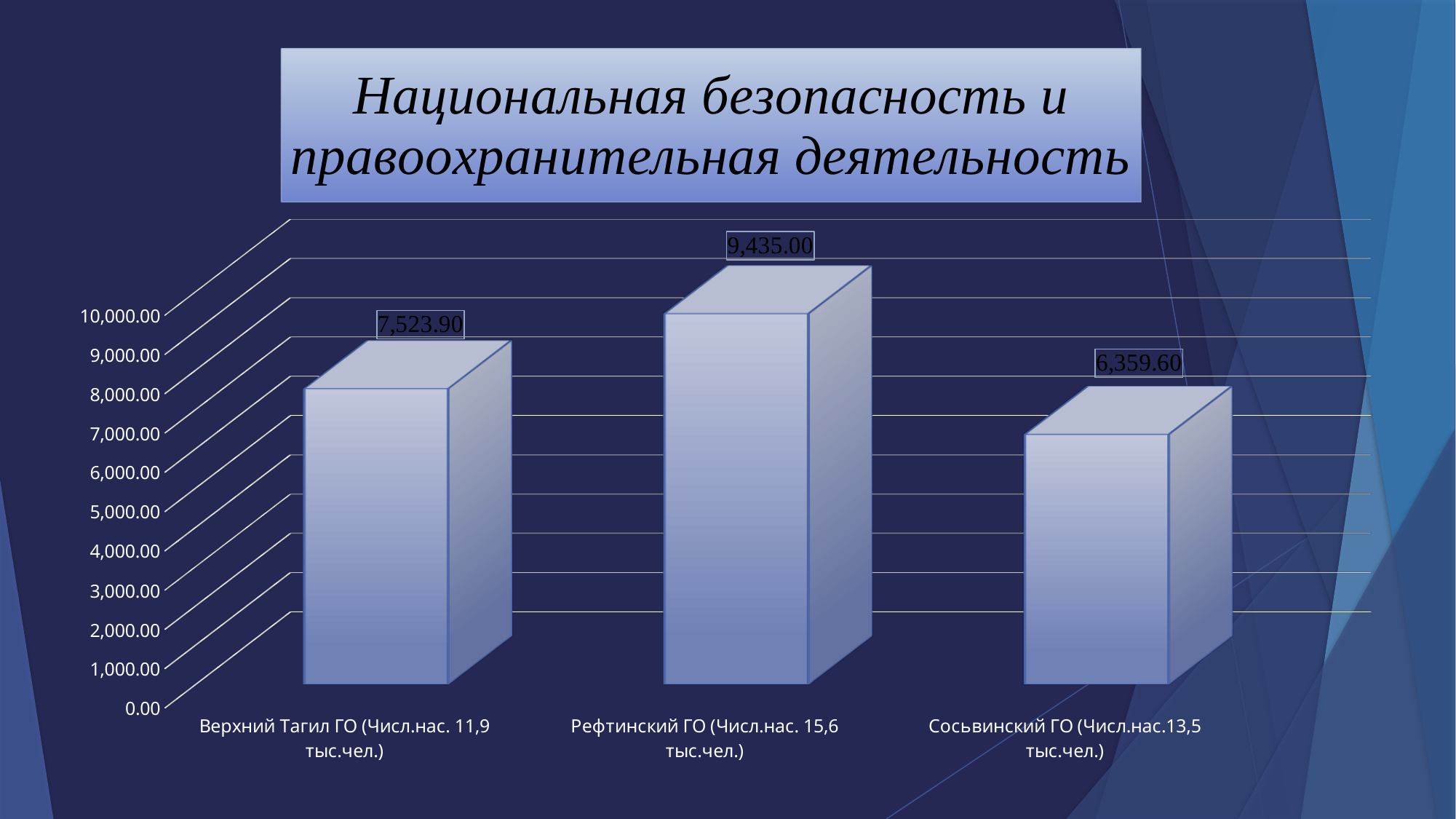
Is the value for Рефтинский ГО greater or less than 9,000.00? greater What is the difference between the values for Верхний Тагил ГО and Сосьвинский ГО? 1,164.30 What kind of chart is shown on the slide? bar chart How many categories are shown in the chart? 3 Which category has the highest value? Рефтинский ГО What is the title of the slide? Национальная безопасность и правоохранительная деятельность What is the value for Верхний Тагил ГО? 7,523.90 Which category has the lowest value? Сосьвинский ГО What is the value for Рефтинский ГО? 9,435.00 What is the difference between the values for Рефтинский ГО and Верхний Тагил ГО? 1,911.10 Which is larger, the value for Верхний Тагил ГО or the value for Сосьвинский ГО? Верхний Тагил ГО What is the value for Сосьвинский ГО? 6,359.60